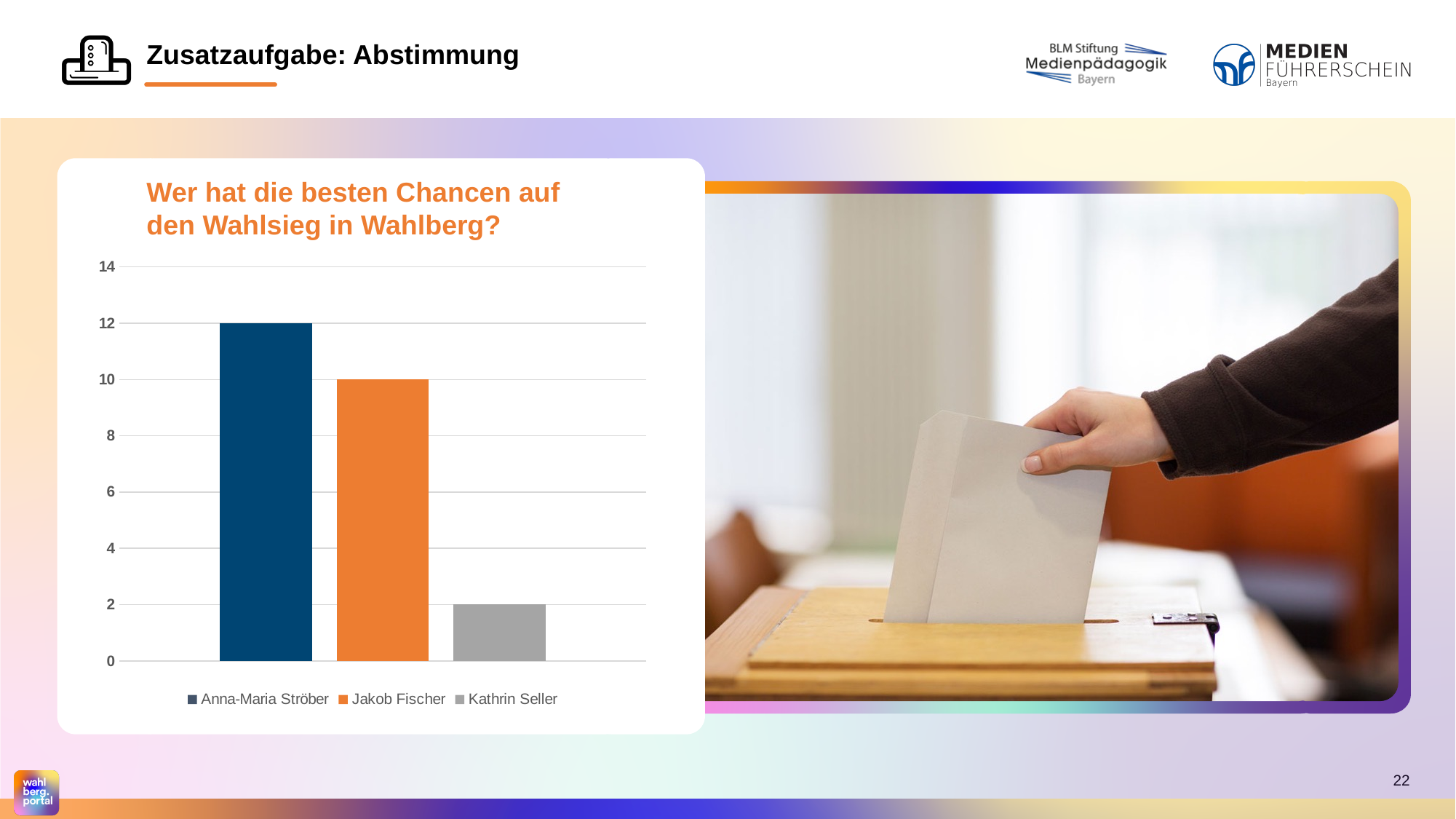
Which candidate has the lowest value? Kathrin Seller Is the value for Anna-Maria Ströber greater or less than 8? greater What kind of chart is shown on the slide? Bar chart What is the title of the chart? Wer hat die besten Chancen auf den Wahlsieg in Wahlberg? Which is larger, the value for Jakob Fischer or the value for Kathrin Seller? Jakob Fischer What is the value for Anna-Maria Ströber? 12 Which candidate has the highest value? Anna-Maria Ströber What is the difference between the values for Anna-Maria Ströber and Jakob Fischer? 2 What is the value for Jakob Fischer? 10 What is the difference between the values for Jakob Fischer and Kathrin Seller? 8 What is the value for Kathrin Seller? 2 How many series does the legend list? 3